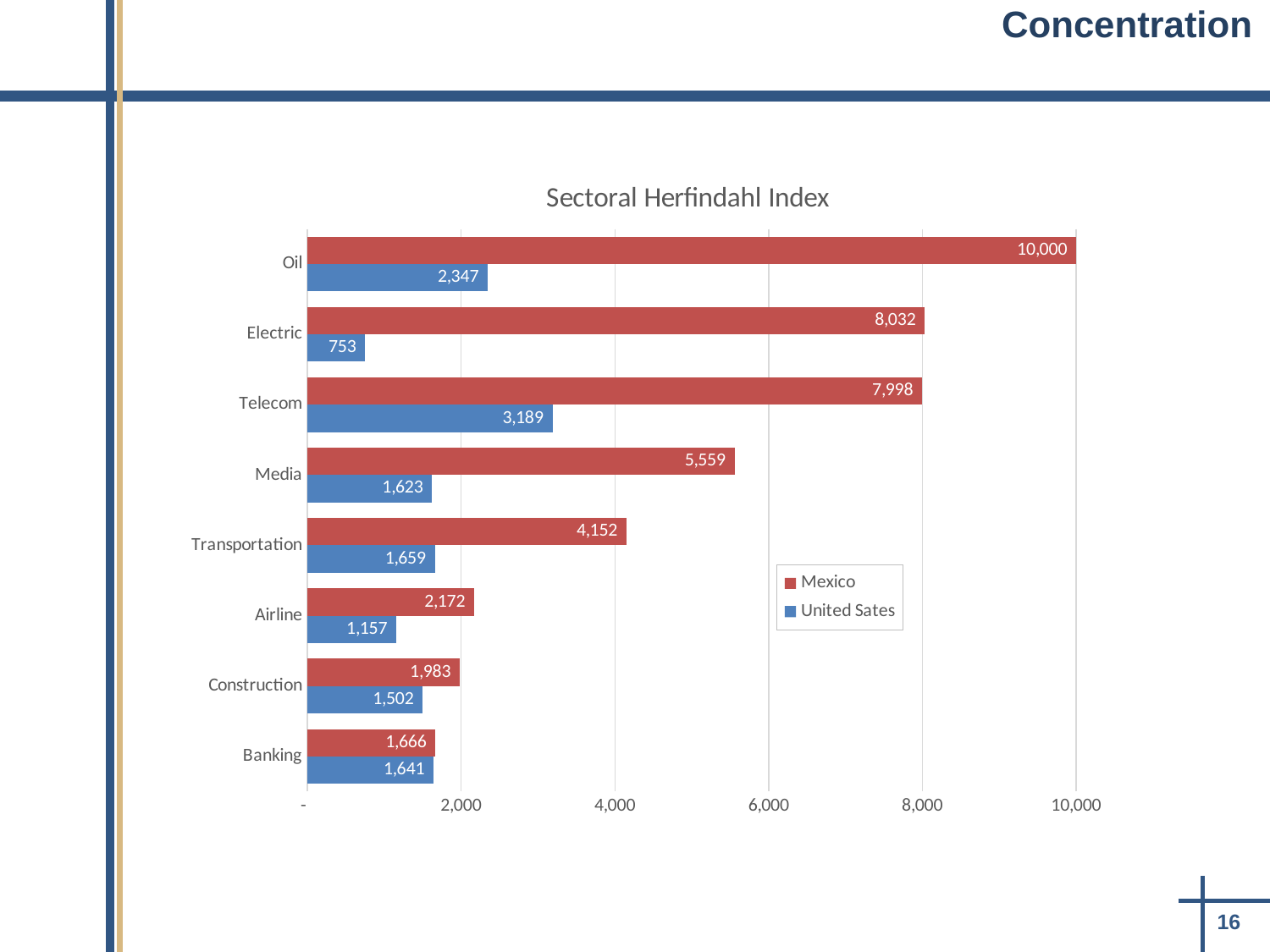
What colour are the Mexico bars? red How many series does the legend list? 2 How many sectors are shown on the chart? 8 What is the title of the chart? Sectoral Herfindahl Index What is the United Sates value for Electric? 753 Which sector has the lowest United Sates value? Electric What kind of chart is shown on the slide? bar chart What is the Mexico value for Telecom? 7,998 Is the Mexico value for Transportation greater or less than 4,000? greater Which is larger for Media: the Mexico value or the United Sates value? Mexico Which sector has the highest Mexico value? Oil What is the difference between the Mexico and United Sates values for Oil? 7,653